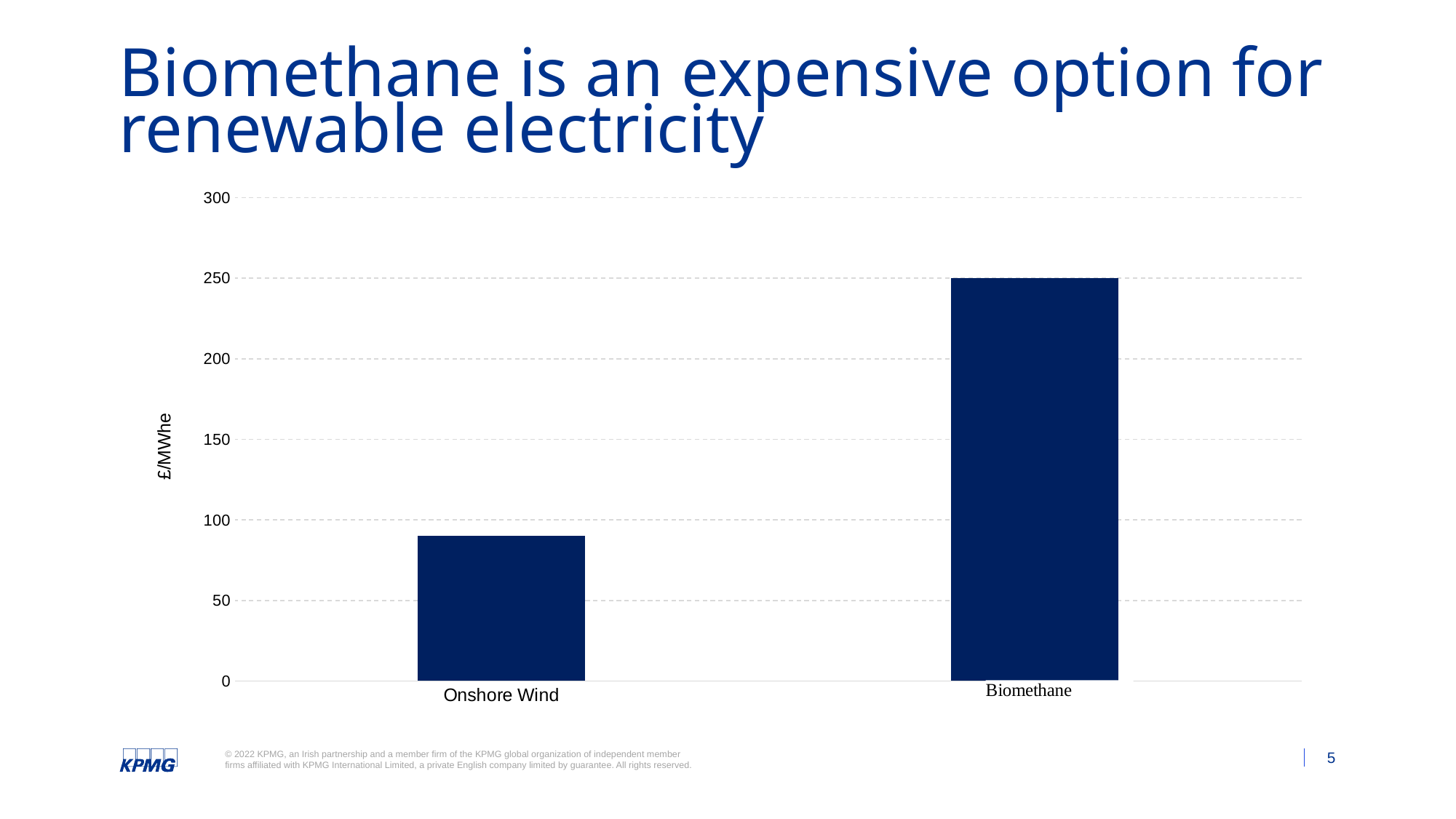
How many categories are plotted in the chart? 2 What kind of chart is shown on the slide? bar chart What is the label on the vertical axis of the chart? £/MWhe Which category has the lowest value in the chart? Onshore Wind Is the value for Onshore Wind greater or less than 100? less Is the value for Biomethane greater or less than 200? greater Is the value for Onshore Wind greater or less than 50? greater What is the highest value shown on the vertical axis of the chart? 300 What is the value for Biomethane in £/MWhe? 250 Which category has the highest value in the chart? Biomethane Which is larger, the value for Onshore Wind or the value for Biomethane? Biomethane